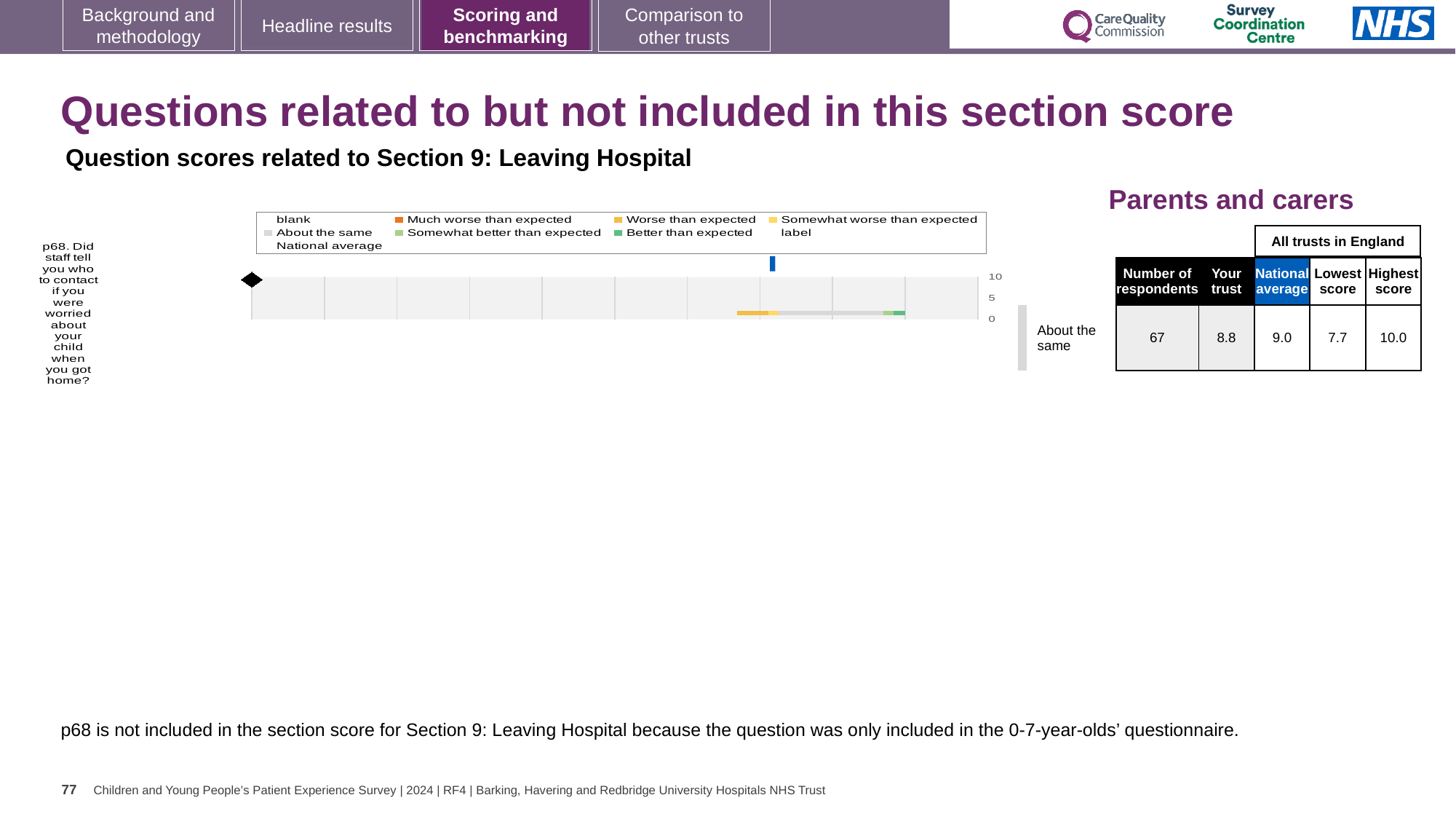
Which legend entry is shown with a grey colour? About the same What is the 'Your trust' score for p68 in the table next to the chart? 8.8 How many respondents answered p68? 67 What is the difference between the highest and lowest scores for p68 across all trusts in England? 2.3 What kind of chart is shown for question p68? bar chart What is the highest value shown on the chart's axis? 10 What is the lowest score among all trusts in England for p68? 7.7 What is the highest score among all trusts in England for p68? 10.0 What is the national average score for p68? 9.0 How many questions (categories) are plotted in the chart? 1 Which is larger for p68, the trust's score or the national average? national average